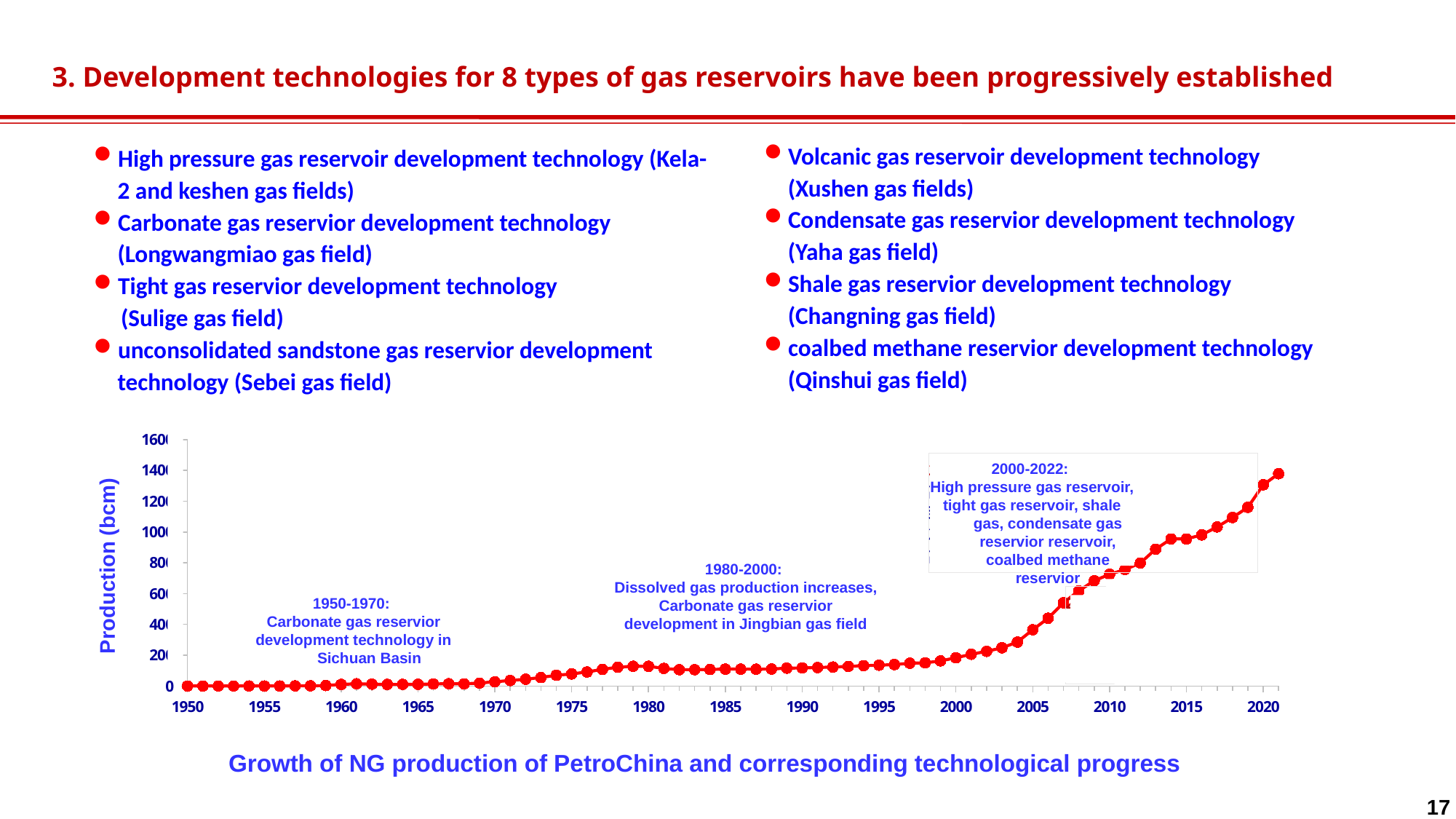
What is the highest value shown on the y axis of the chart? 160 Is the production value for 1950 greater or less than 20? less Is the production value for 2015 greater or less than 80? greater Which year has the larger production value, 1960 or 2005? 2005 Is the production value for 2020 greater or less than 100? greater What is the label of the y axis of the chart? Production (bcm) What kind of chart is shown on the slide? line chart What is the caption below the chart? Growth of NG production of PetroChina and corresponding technological progress Which year has the larger production value, 1990 or 2020? 2020 Does production rise or fall from 1950 to 2020 along the x axis? rise